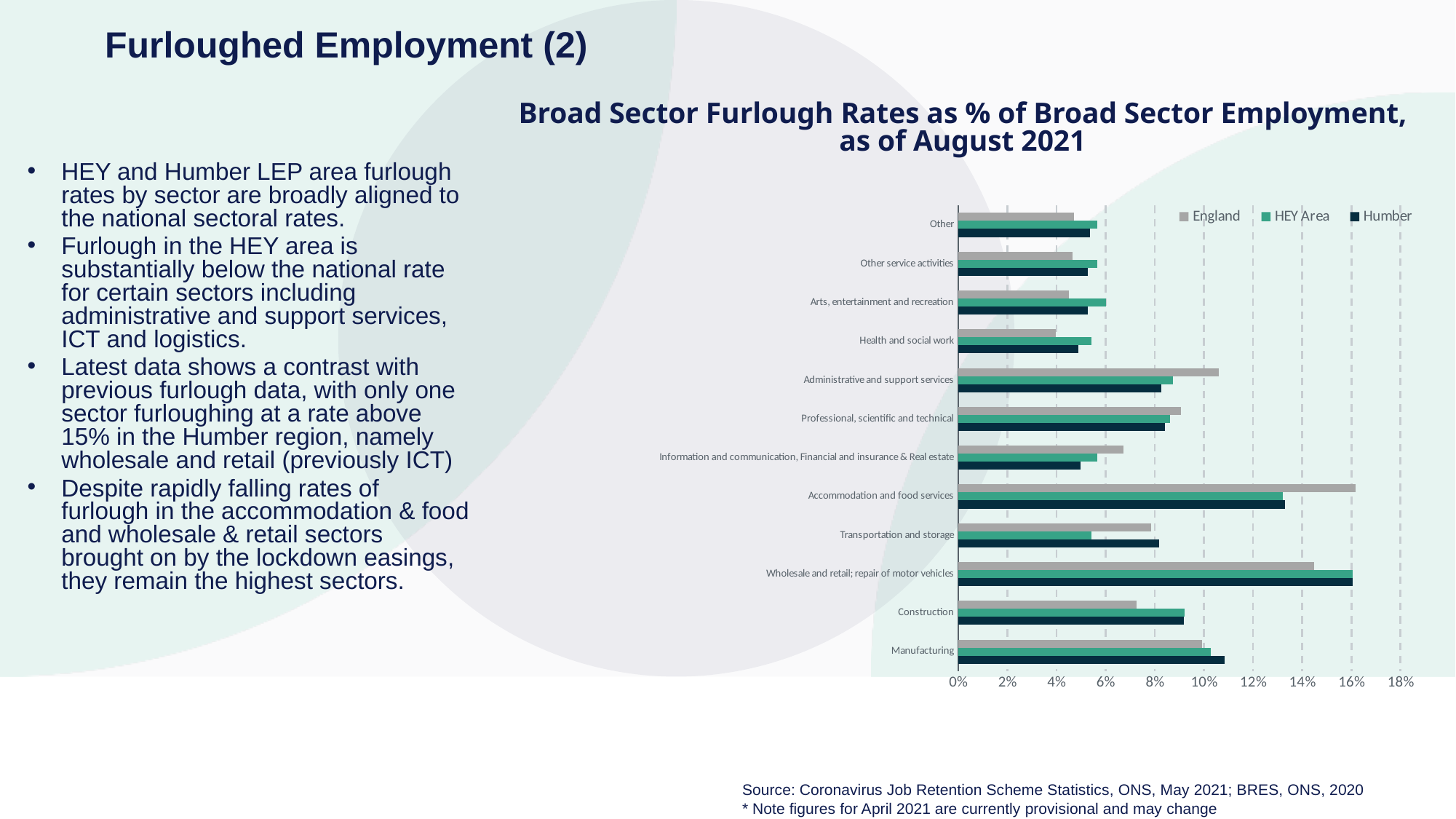
Which sector has the lowest England furlough rate? Health and social work Is the England value for Administrative and support services greater or less than 10%? greater Is the HEY Area value for Transportation and storage greater or less than 6%? less What is the title of the chart? Broad Sector Furlough Rates as % of Broad Sector Employment, as of August 2021 Which sector has the highest England furlough rate? Accommodation and food services What kind of chart is shown on the slide? Bar chart How many series does the chart legend list? 3 For Accommodation and food services, which is larger: the England value or the HEY Area value? England Which sector has the highest HEY Area furlough rate? Wholesale and retail; repair of motor vehicles Is the England value for Construction greater or less than 8%? less For Construction, which is larger: the HEY Area value or the England value? HEY Area How many sector categories are plotted on the chart? 12